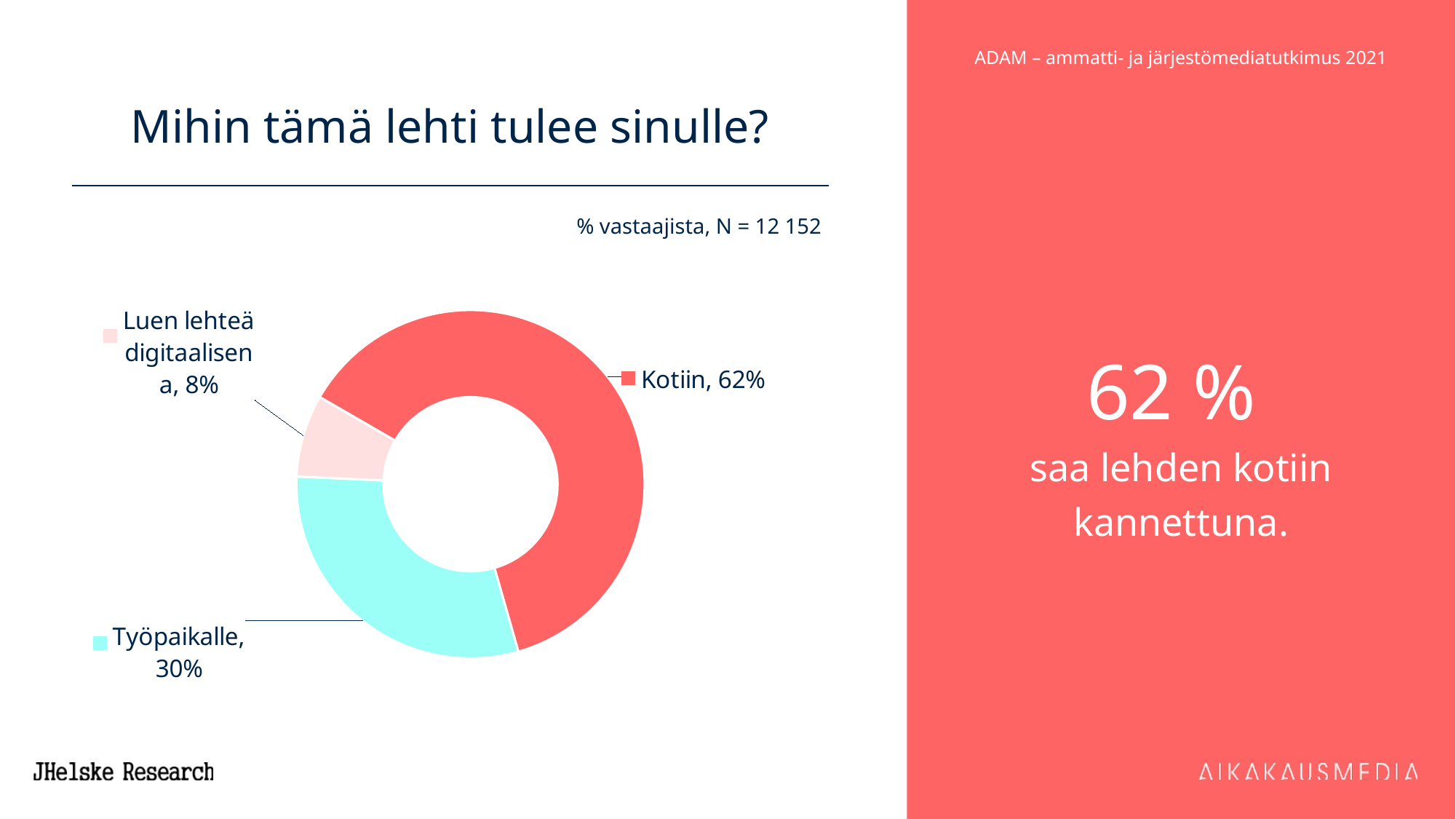
What percentage of respondents answered "Työpaikalle"? 30% Which is larger, the share for "Työpaikalle" or for "Luen lehteä digitaalisena"? Työpaikalle What percentage of respondents answered "Kotiin"? 62% Which category has the largest share of the chart? Kotiin Which category has the smallest share of the chart? Luen lehteä digitaalisena How many categories does the chart show? 3 What percentage of respondents answered "Luen lehteä digitaalisena"? 8% What kind of chart is shown on the slide? Doughnut (pie) chart What is the number of respondents (N) stated above the chart? 12 152 What is the difference in percentage points between "Kotiin" and "Työpaikalle"? 32 What is the title of the slide above the chart? Mihin tämä lehti tulee sinulle? What is the difference in percentage points between "Työpaikalle" and "Luen lehteä digitaalisena"? 22